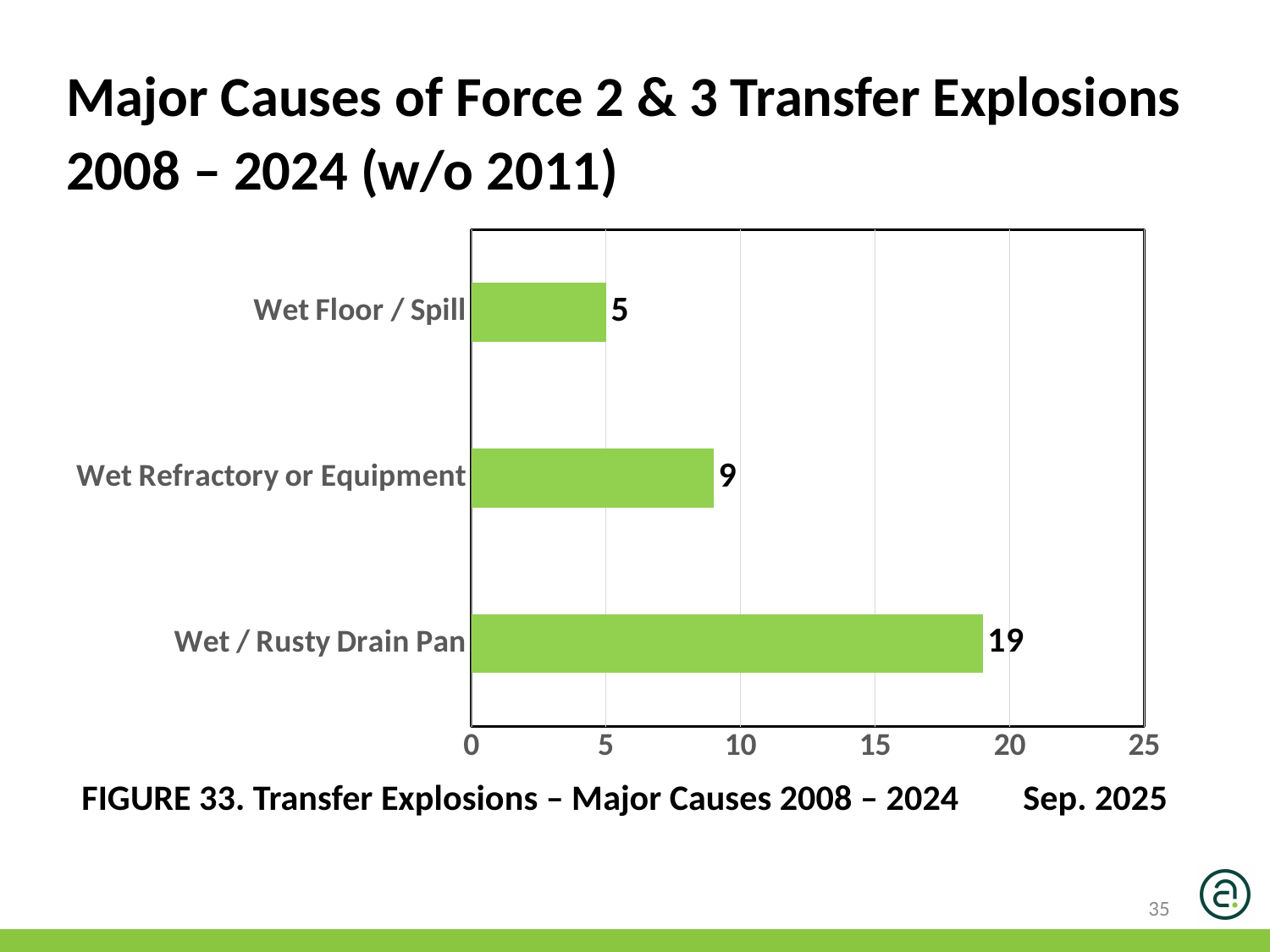
Is the value for Wet / Rusty Drain Pan greater or less than 15? greater What is the value for Wet / Rusty Drain Pan? 19 What is the difference between the values for Wet Refractory or Equipment and Wet Floor / Spill? 4 Which is larger, the value for Wet Refractory or Equipment or the value for Wet Floor / Spill? Wet Refractory or Equipment What is the difference between the values for Wet / Rusty Drain Pan and Wet Refractory or Equipment? 10 What kind of chart is shown on the slide? bar chart Which cause has the highest value? Wet / Rusty Drain Pan What is the value for Wet Floor / Spill? 5 What is the figure caption below the chart? FIGURE 33. Transfer Explosions – Major Causes 2008 – 2024 Which cause has the lowest value? Wet Floor / Spill How many causes are shown in the chart? 3 What is the value for Wet Refractory or Equipment? 9